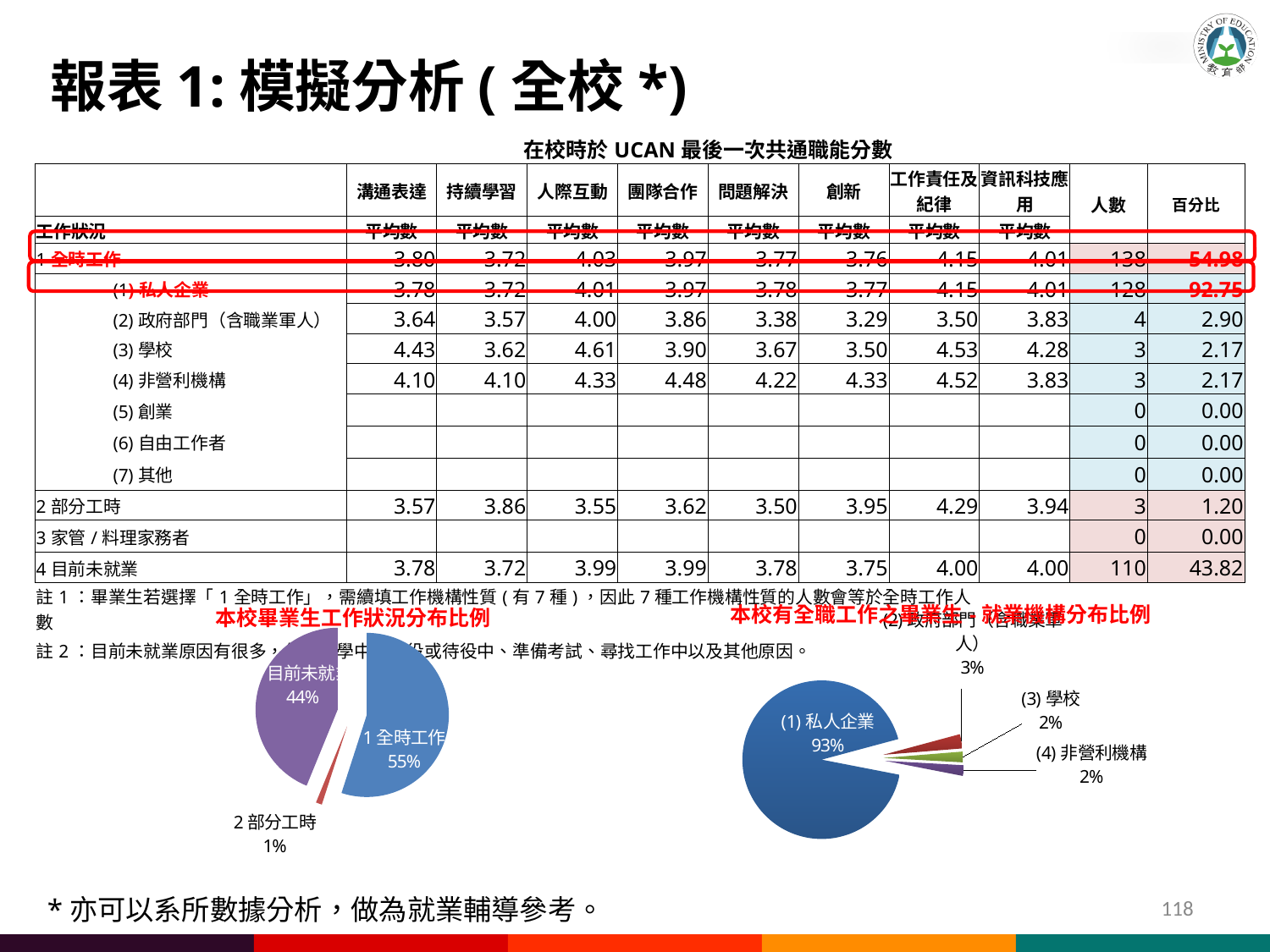
In the left pie chart (本校畢業生工作狀況分布比例), what share is shown for 1 全時工作? 55% In the left pie chart (本校畢業生工作狀況分布比例), which slice is the largest? 1 全時工作 In the left pie chart (本校畢業生工作狀況分布比例), what is the difference in percentage points between 1 全時工作 and 目前未就業? 11 In the left pie chart (本校畢業生工作狀況分布比例), how many slices are shown? 3 What kind of chart is the right chart titled 本校有全職工作之畢業生 就業機構分布比例? pie chart In the left pie chart (本校畢業生工作狀況分布比例), what share is shown for 2 部分工時? 1% In the right pie chart (本校有全職工作之畢業生 就業機構分布比例), how many slices are shown? 4 In the left pie chart (本校畢業生工作狀況分布比例), which slice is the smallest? 2 部分工時 In the right pie chart (本校有全職工作之畢業生 就業機構分布比例), what share is shown for (1) 私人企業? 93% In the right pie chart (本校有全職工作之畢業生 就業機構分布比例), which slice is the largest? (1) 私人企業 What kind of chart is the left chart titled 本校畢業生工作狀況分布比例? pie chart In the right pie chart (本校有全職工作之畢業生 就業機構分布比例), what share is shown for (3) 學校? 2%